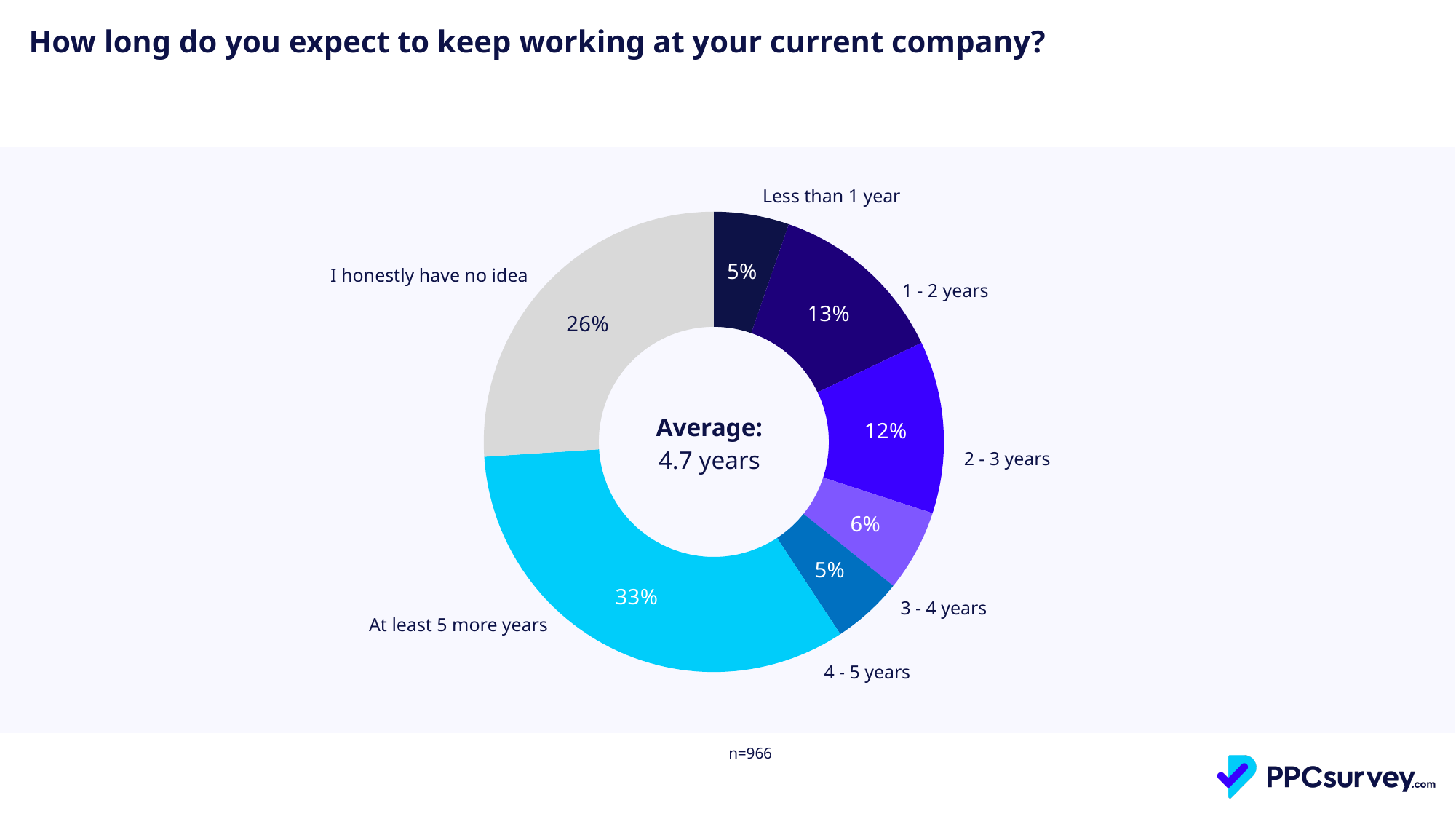
What is the combined share of respondents expecting to stay 3 - 4 years or 4 - 5 years? 11% What percentage of respondents answered 'I honestly have no idea'? 26% What share of respondents expect to stay 1 - 2 years? 13% What is the sample size (n) shown on the slide? 966 What share of respondents expect to keep working at their current company for at least 5 more years? 33% How many response categories are shown in the chart? 7 What percentage of respondents expect to stay less than 1 year? 5% What is the average expected tenure shown in the centre of the chart? 4.7 years What is the difference in percentage points between '2 - 3 years' and '3 - 4 years'? 6 Which response category has the largest share? At least 5 more years What kind of chart is shown on the slide? Pie chart (donut) Which is larger: the share for '1 - 2 years' or the share for '2 - 3 years'? 1 - 2 years